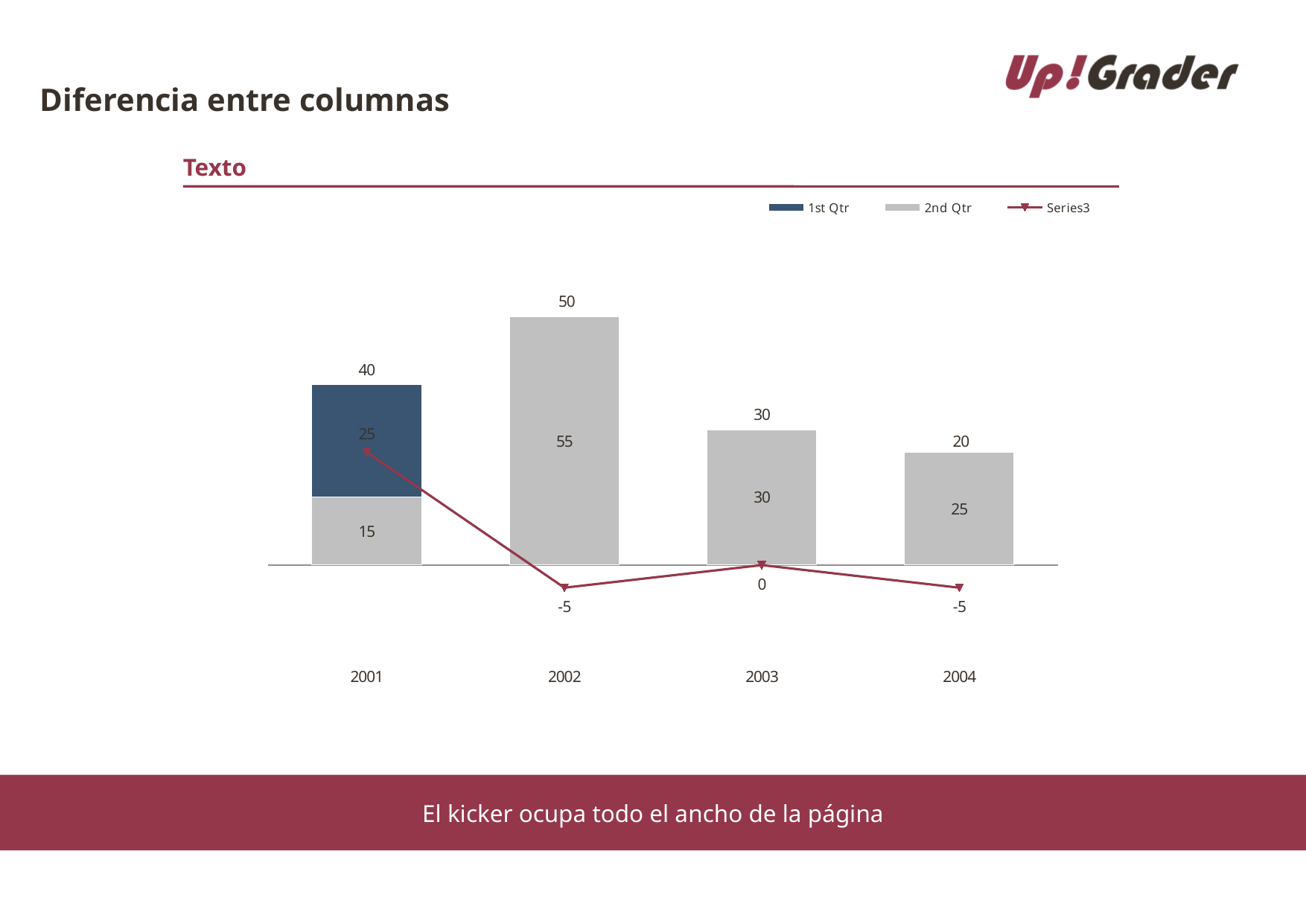
What is the Series3 line value at 2002? -5 What kind of chart is shown on the slide? bar chart with a line What value is printed inside the grey 2nd Qtr bar for 2001? 15 How many series does the chart legend list? 3 How many years are shown on the x axis of the chart? 4 What value is printed above the bar for 2004? 20 Which colour represents 1st Qtr in the legend? dark blue What is the difference between the grey 2nd Qtr values for 2002 and 2004? 30 What is the Series3 line value at 2003? 0 What value is printed inside the grey 2nd Qtr bar for 2002? 55 Which year has the tallest grey 2nd Qtr bar? 2002 What value is printed inside the dark blue 1st Qtr segment for 2001? 25